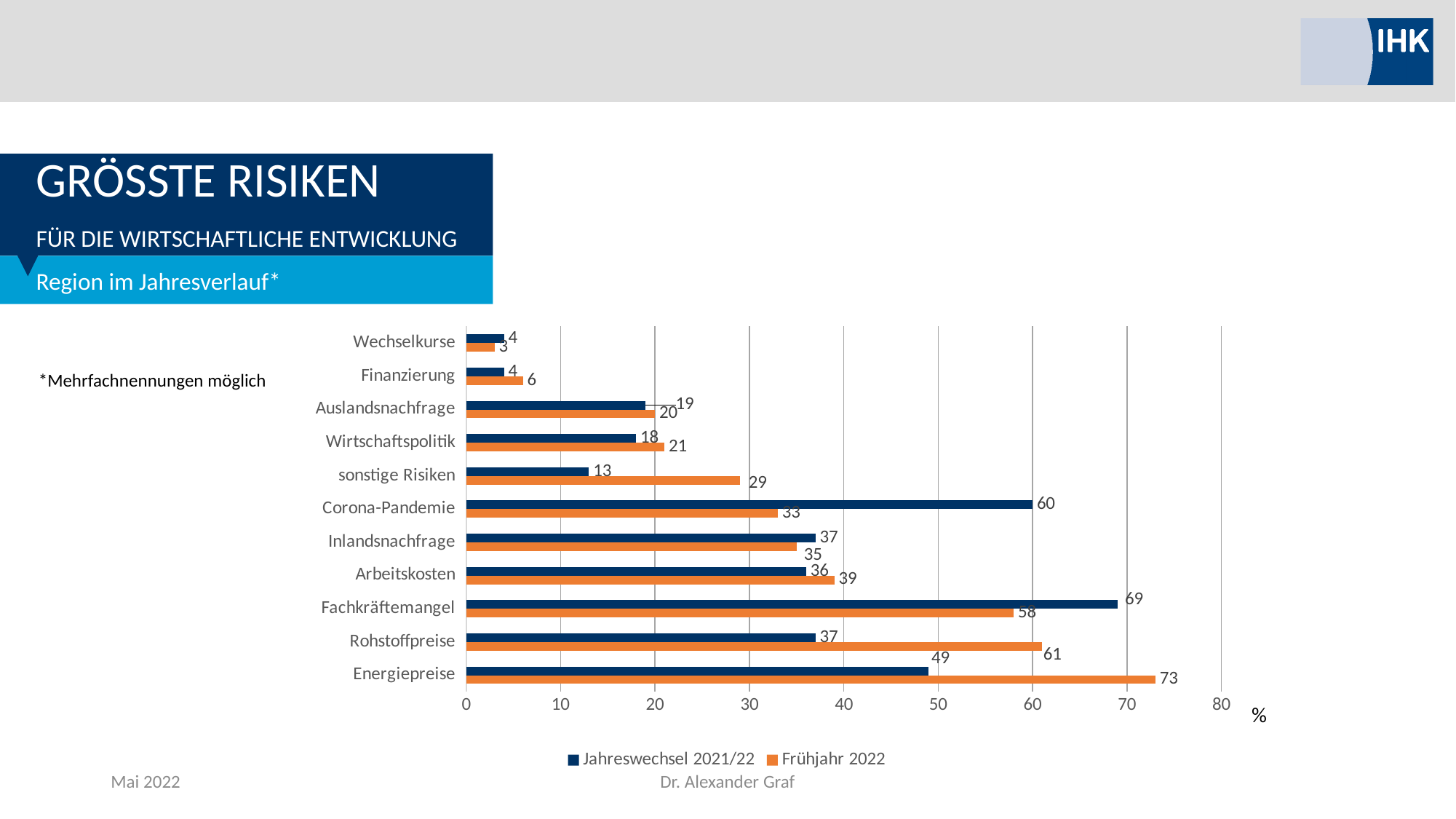
What is the Frühjahr 2022 value for sonstige Risiken? 29 For Corona-Pandemie, which series has the larger value: Jahreswechsel 2021/22 or Frühjahr 2022? Jahreswechsel 2021/22 Which category has the lowest Frühjahr 2022 value? Wechselkurse Is the Frühjahr 2022 value for Fachkräftemangel greater or less than 50? greater What is the Frühjahr 2022 value for Energiepreise? 73 What is the Jahreswechsel 2021/22 value for Corona-Pandemie? 60 How many risk categories are shown on the chart? 11 Which colour represents the Frühjahr 2022 series? Orange What kind of chart is shown on the slide? Bar chart Which category has the highest Jahreswechsel 2021/22 value? Fachkräftemangel What is the difference between the Frühjahr 2022 and Jahreswechsel 2021/22 values for Rohstoffpreise? 24 How many series does the legend list? 2